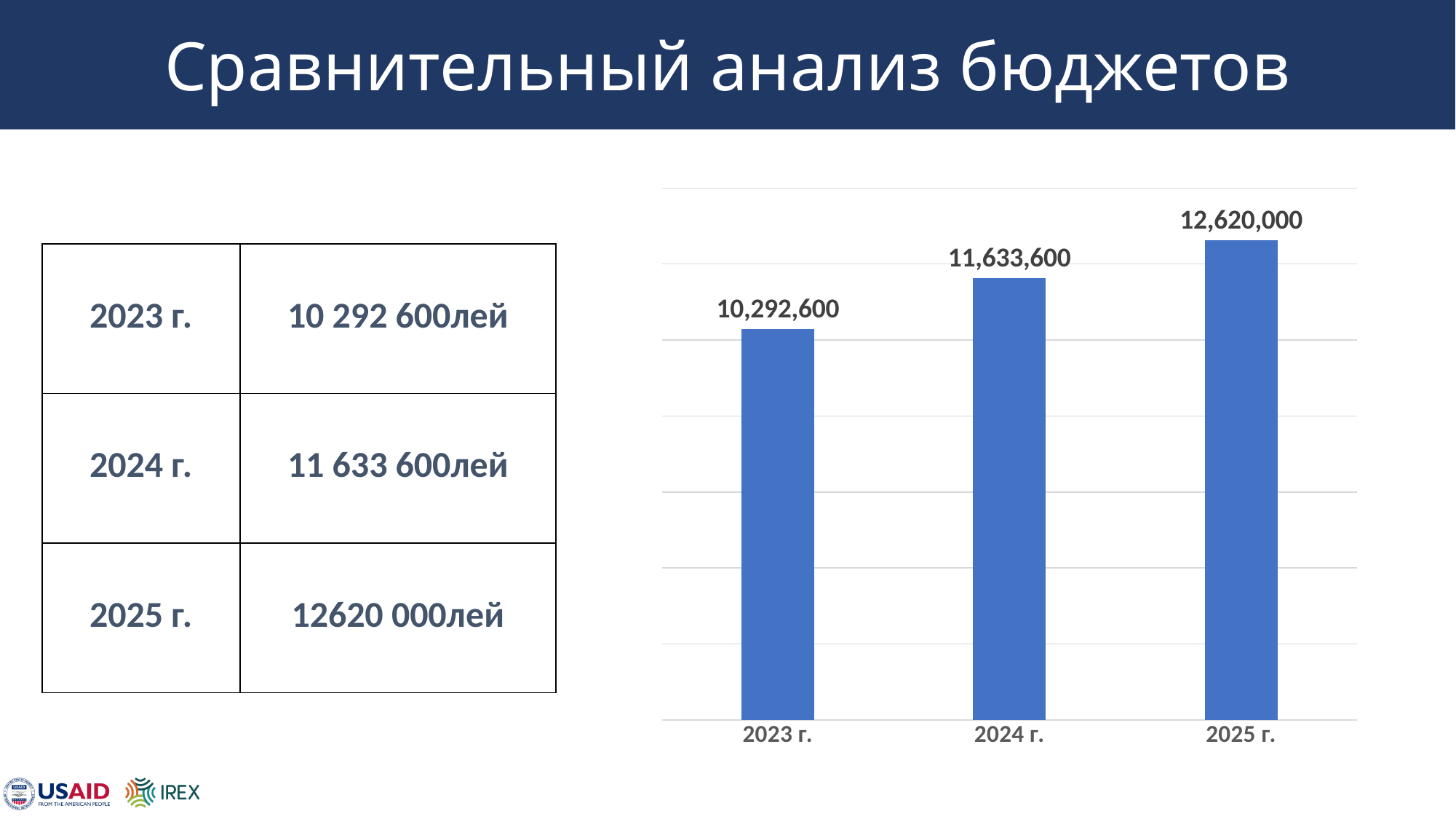
Which year has the highest value in the bar chart? 2025 г. What is the difference between the values for 2024 г. and 2023 г.? 1,341,000 What is the difference between the values for 2025 г. and 2024 г.? 986,400 What type of chart is shown on the slide? Bar chart What is the value shown for 2025 г. in the bar chart? 12,620,000 What is the value shown for 2023 г. in the bar chart? 10,292,600 Which is larger, the value for 2024 г. or the value for 2025 г.? 2025 г. Which year has the lowest value in the bar chart? 2023 г. How many bars are shown in the chart? 3 What is the difference between the values for 2025 г. and 2023 г.? 2,327,400 What is the value shown for 2024 г. in the bar chart? 11,633,600 Do the values rise or fall from 2023 г. to 2025 г.? Rise